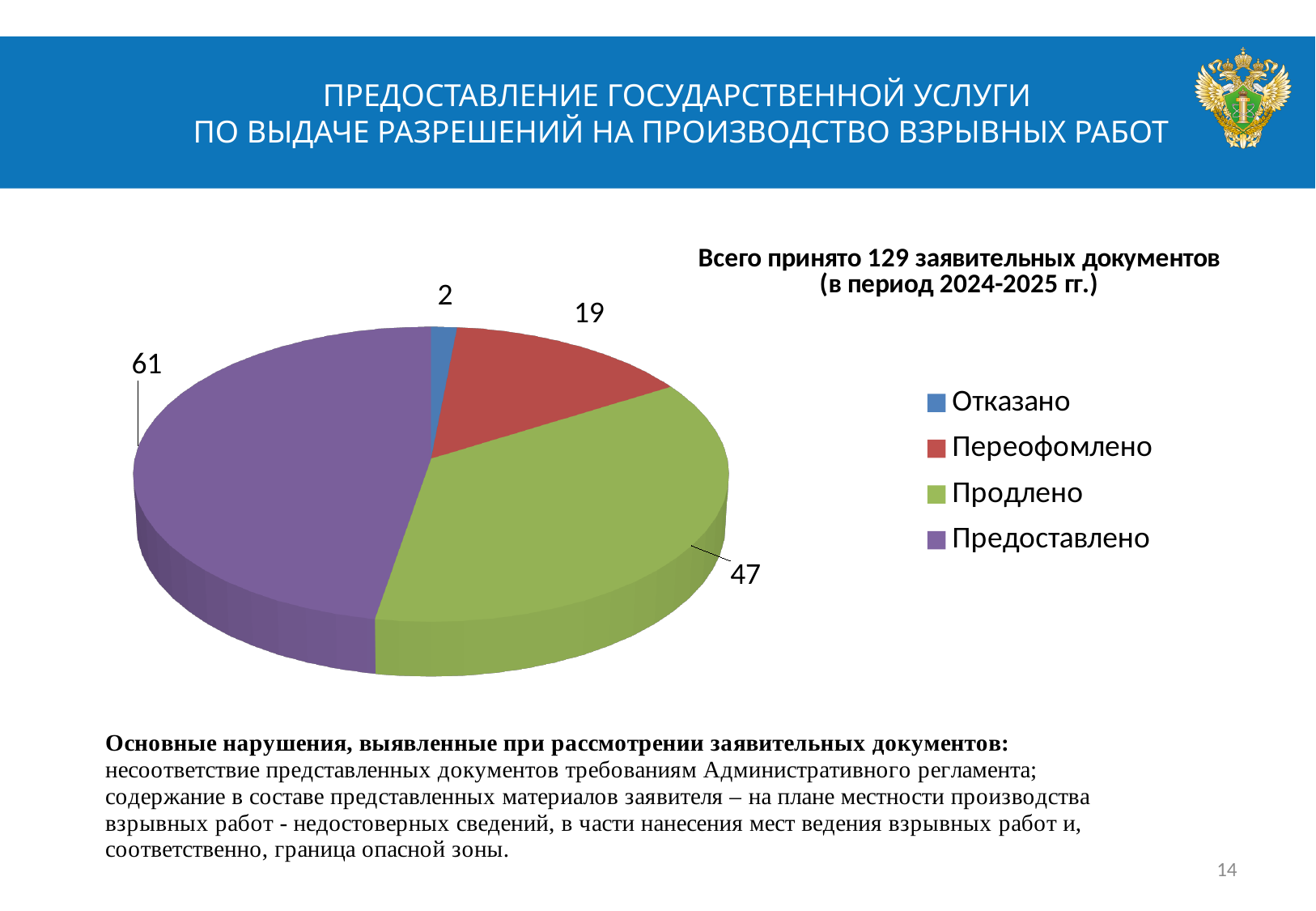
What type of chart is shown on the slide? pie chart How many categories does the pie chart show? 4 What is the value for Переофомлено in the pie chart? 19 Which is larger, the value for Переофомлено or the value for Продлено? Продлено What colour is the Продлено slice in the pie chart? green What is the value for Предоставлено in the pie chart? 61 Which category has the largest slice in the pie chart? Предоставлено What is the value for Отказано in the pie chart? 2 Which category has the smallest slice in the pie chart? Отказано What is the difference between the values for Предоставлено and Продлено? 14 What is the value for Продлено in the pie chart? 47 What is the total of all slices in the pie chart? 129